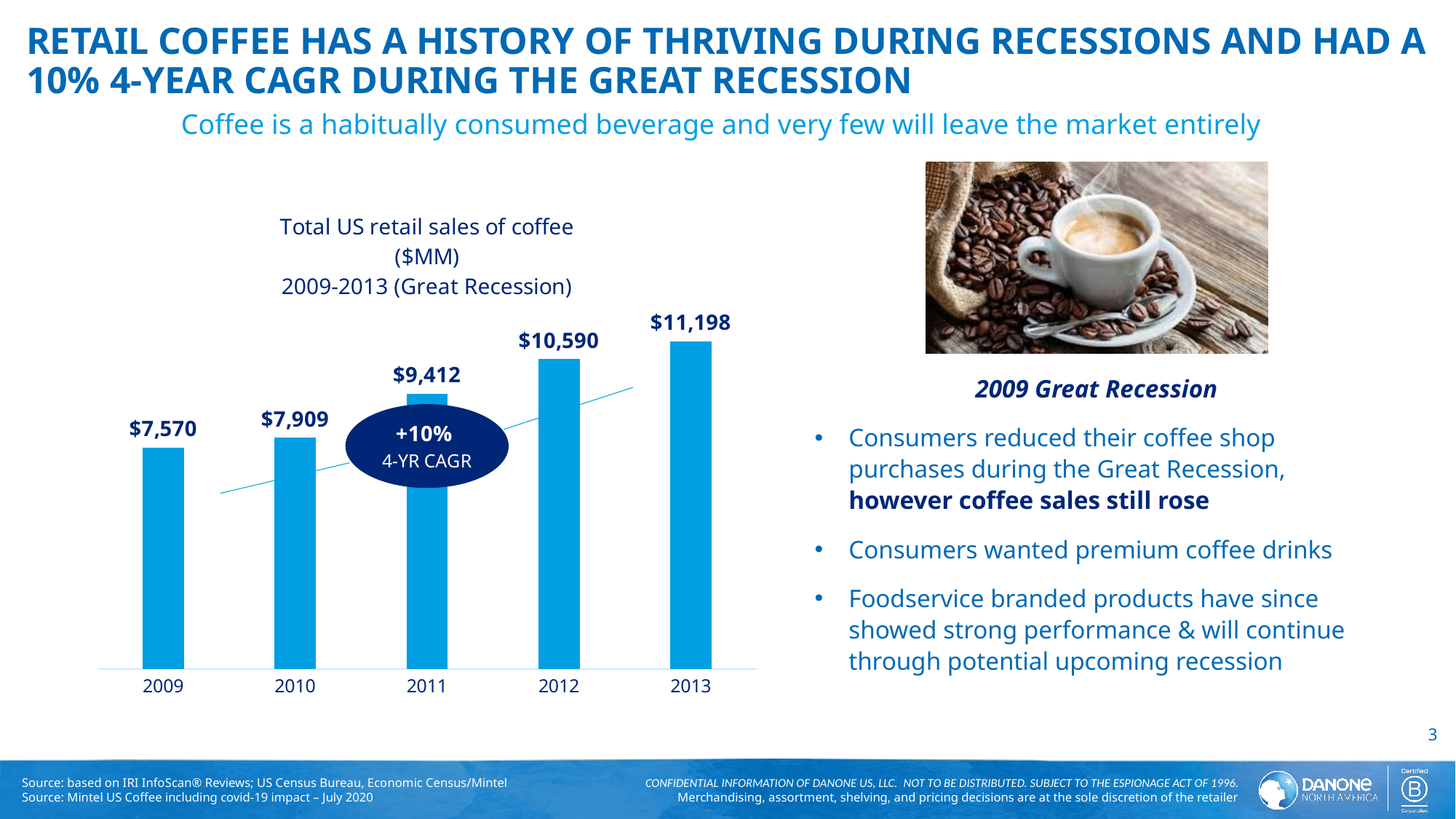
What is the difference in total US retail sales of coffee between 2012 and 2011? $1,178 What 4-year CAGR is called out on the chart? +10% What were total US retail sales of coffee in 2013? $11,198 What were total US retail sales of coffee in 2009? $7,570 What were total US retail sales of coffee in 2011? $9,412 Which year had higher total US retail sales of coffee, 2010 or 2012? 2012 Which year has the lowest total US retail sales of coffee? 2009 Which year has the highest total US retail sales of coffee? 2013 What kind of chart is used to show total US retail sales of coffee? Bar chart Do total US retail sales of coffee rise or fall from 2009 to 2013? Rise What is the difference in total US retail sales of coffee between 2013 and 2009? $3,628 How many years are shown on the chart? 5